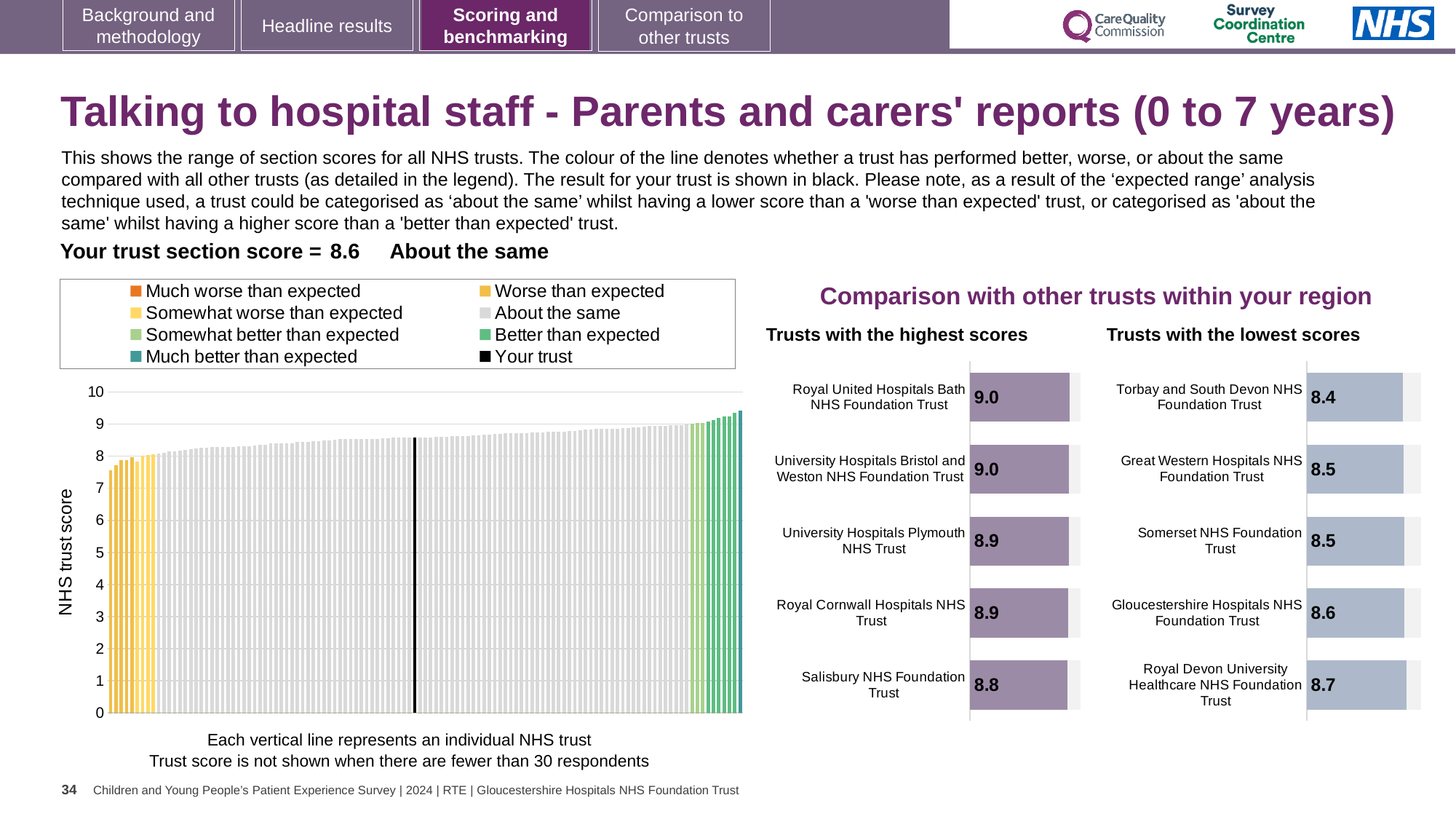
In the 'Trusts with the lowest scores' chart, which trust has the lowest score? Torbay and South Devon NHS Foundation Trust In the 'Trusts with the lowest scores' chart, what is the score for Torbay and South Devon NHS Foundation Trust? 8.4 In the 'Trusts with the highest scores' chart, which trust has the lowest score shown? Salisbury NHS Foundation Trust In the 'Trusts with the highest scores' chart, what is the score for University Hospitals Plymouth NHS Trust? 8.9 In the 'Trusts with the lowest scores' chart, what is the score for Royal Devon University Healthcare NHS Foundation Trust? 8.7 In the 'Trusts with the lowest scores' chart, which is larger: the score for Gloucestershire Hospitals NHS Foundation Trust or the score for Great Western Hospitals NHS Foundation Trust? Gloucestershire Hospitals NHS Foundation Trust In the 'Trusts with the highest scores' chart, what is the difference between the score for Royal United Hospitals Bath NHS Foundation Trust and the score for Salisbury NHS Foundation Trust? 0.2 How many entries does the legend of the left-hand chart list? 8 In the left-hand chart of all NHS trusts, is the value for the leftmost bar greater or less than 8? less How many trusts are listed in the 'Trusts with the lowest scores' chart? 5 In the 'Trusts with the highest scores' chart, what is the score for Salisbury NHS Foundation Trust? 8.8 In the left-hand chart of all NHS trusts, do the bar values rise or fall from left to right? rise